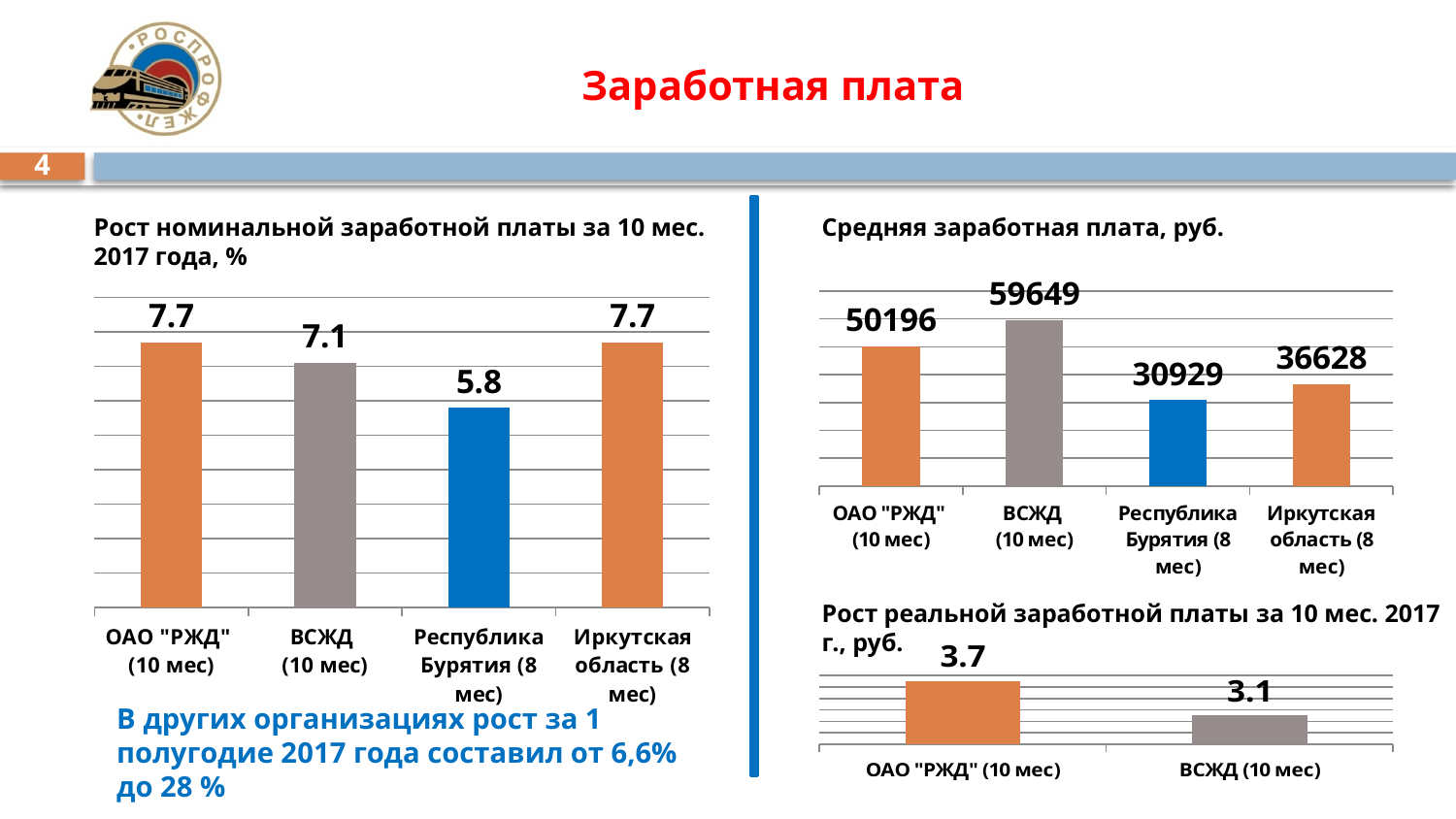
What type of chart is 'Средняя заработная плата, руб.'? Bar chart In the chart 'Средняя заработная плата, руб.', which category has the highest value? ВСЖД (10 мес) In the chart 'Средняя заработная плата, руб.', what is the value for ВСЖД (10 мес)? 59649 In the chart 'Рост реальной заработной платы за 10 мес. 2017 г., руб.', what is the value for ОАО "РЖД" (10 мес)? 3.7 In the chart 'Рост реальной заработной платы за 10 мес. 2017 г., руб.', what is the difference between the values for ОАО "РЖД" (10 мес) and ВСЖД (10 мес)? 0.6 In the chart 'Средняя заработная плата, руб.', what is the difference between the values for ВСЖД (10 мес) and ОАО "РЖД" (10 мес)? 9453 In the chart 'Рост номинальной заработной платы за 10 мес. 2017 года, %', which category has the lowest value? Республика Бурятия (8 мес) In the chart 'Средняя заработная плата, руб.', which is larger: the value for Иркутская область (8 мес) or Республика Бурятия (8 мес)? Иркутская область (8 мес) In the chart 'Рост номинальной заработной платы за 10 мес. 2017 года, %', what is the value for ВСЖД (10 мес)? 7.1 In the chart 'Средняя заработная плата, руб.', which category has the lowest value? Республика Бурятия (8 мес) In the chart 'Рост номинальной заработной платы за 10 мес. 2017 года, %', what is the difference between the values for ОАО "РЖД" (10 мес) and Республика Бурятия (8 мес)? 1.9 How many categories are shown in the chart 'Рост номинальной заработной платы за 10 мес. 2017 года, %'? 4